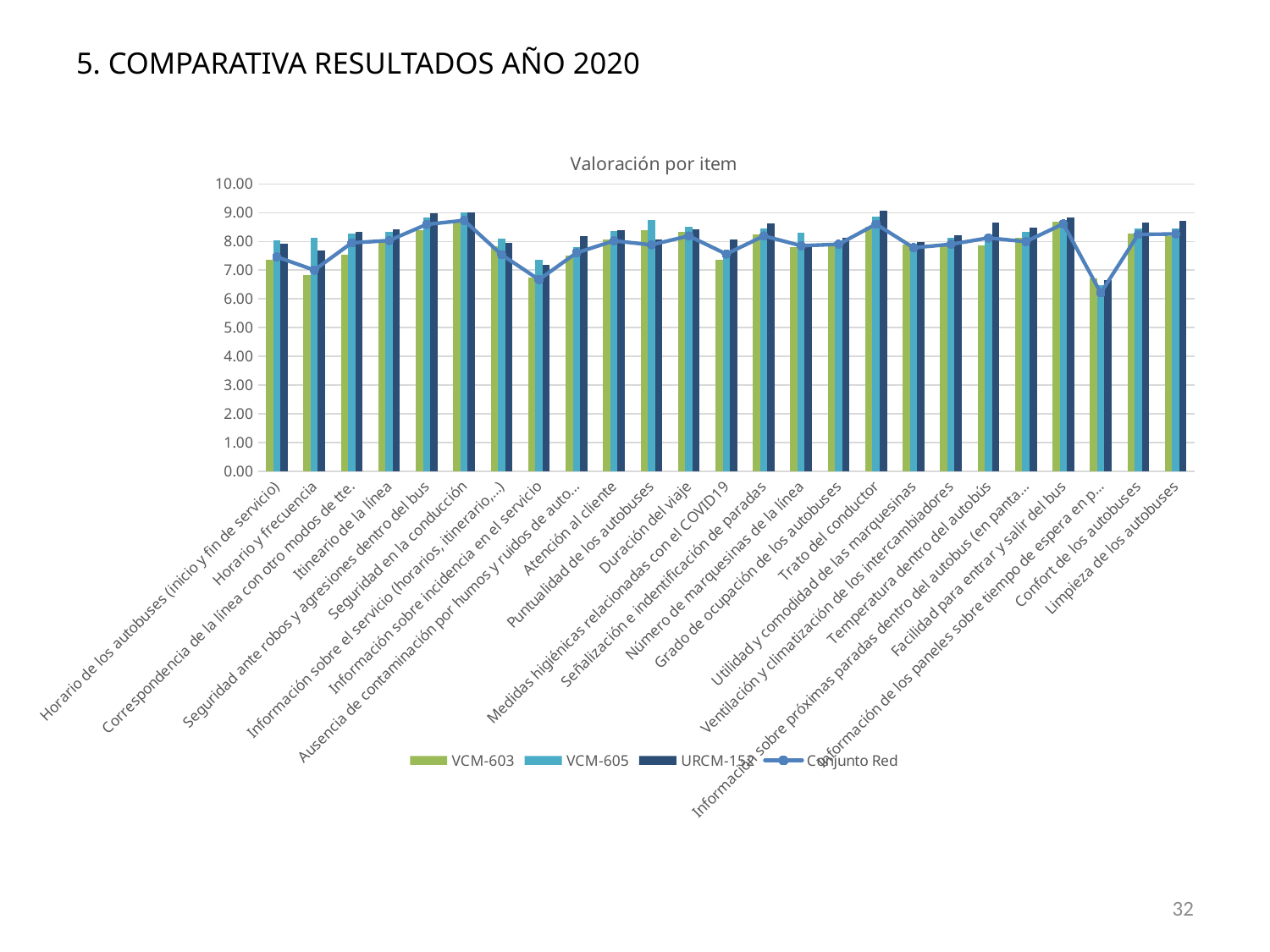
Which series is drawn as a line rather than bars? Conjunto Red What kind of chart is shown on the slide? Bar chart with a line series How many categories are shown on the x axis of the chart? 25 Is the VCM-605 value for 'Puntualidad de los autobuses' greater or less than 8.00? greater How many series does the legend list? 4 Is the Conjunto Red value for 'Información sobre incidencia en el servicio' greater or less than 7.00? less Is the VCM-603 value for 'Medidas higiénicas relacionadas con el COVID19' greater or less than 8.00? less What is the title of the chart? Valoración por item